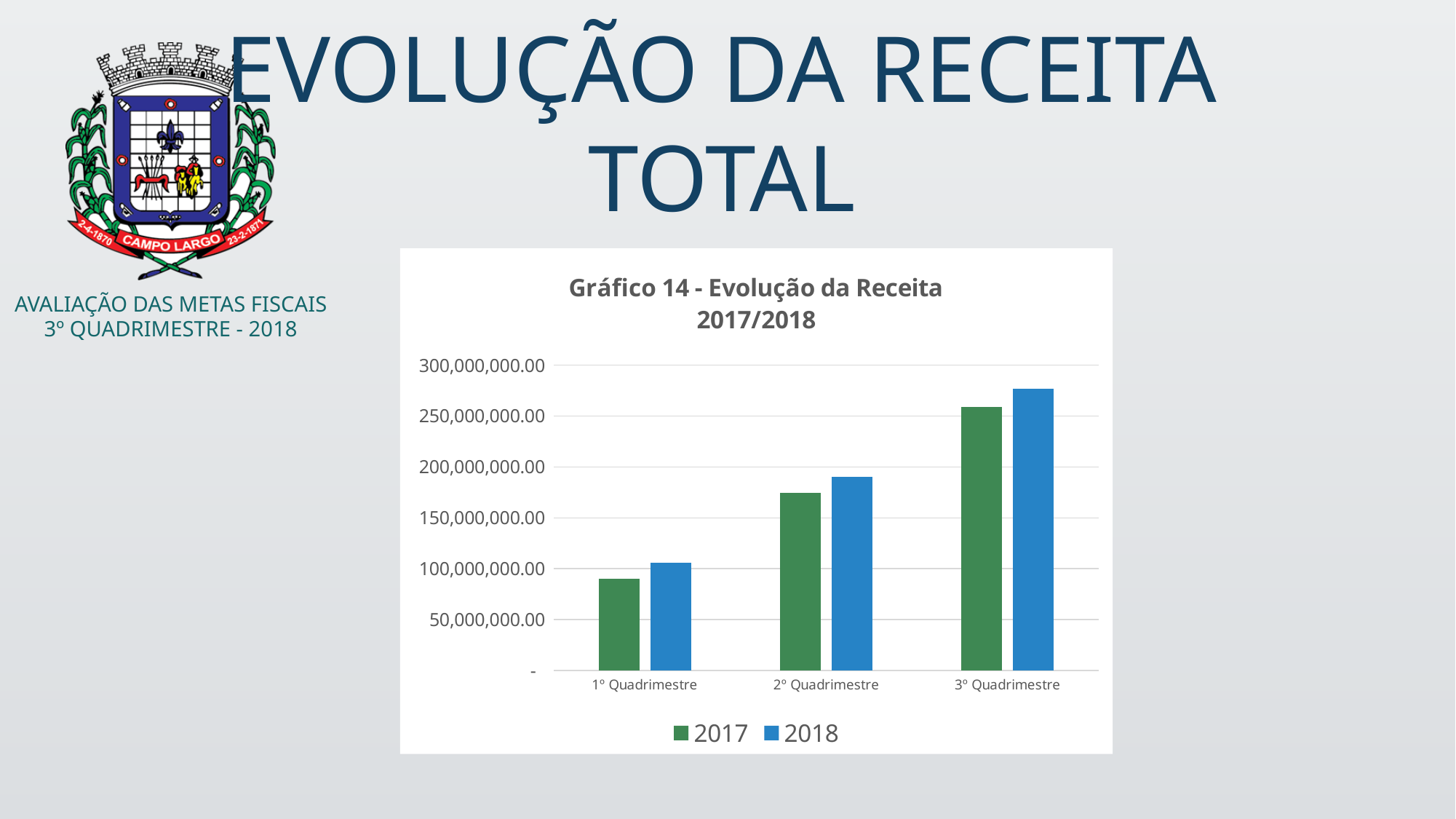
Is the value for 2017 in the 3º Quadrimestre greater or less than 250,000,000.00? greater Which category has the highest value for the 2018 series? 3º Quadrimestre How many series does the legend list? 2 Is the value for 2018 in the 2º Quadrimestre greater or less than 200,000,000.00? less How many categories are shown on the x axis? 3 In the 2º Quadrimestre, which series has the larger value, 2017 or 2018? 2018 Do the values for the 2017 series rise or fall from the 1º Quadrimestre to the 3º Quadrimestre? rise Which category has the lowest value for the 2017 series? 1º Quadrimestre What is the title of the chart? Gráfico 14 - Evolução da Receita 2017/2018 Is the value for 2017 in the 1º Quadrimestre greater or less than 100,000,000.00? less What kind of chart is shown on the slide? bar chart